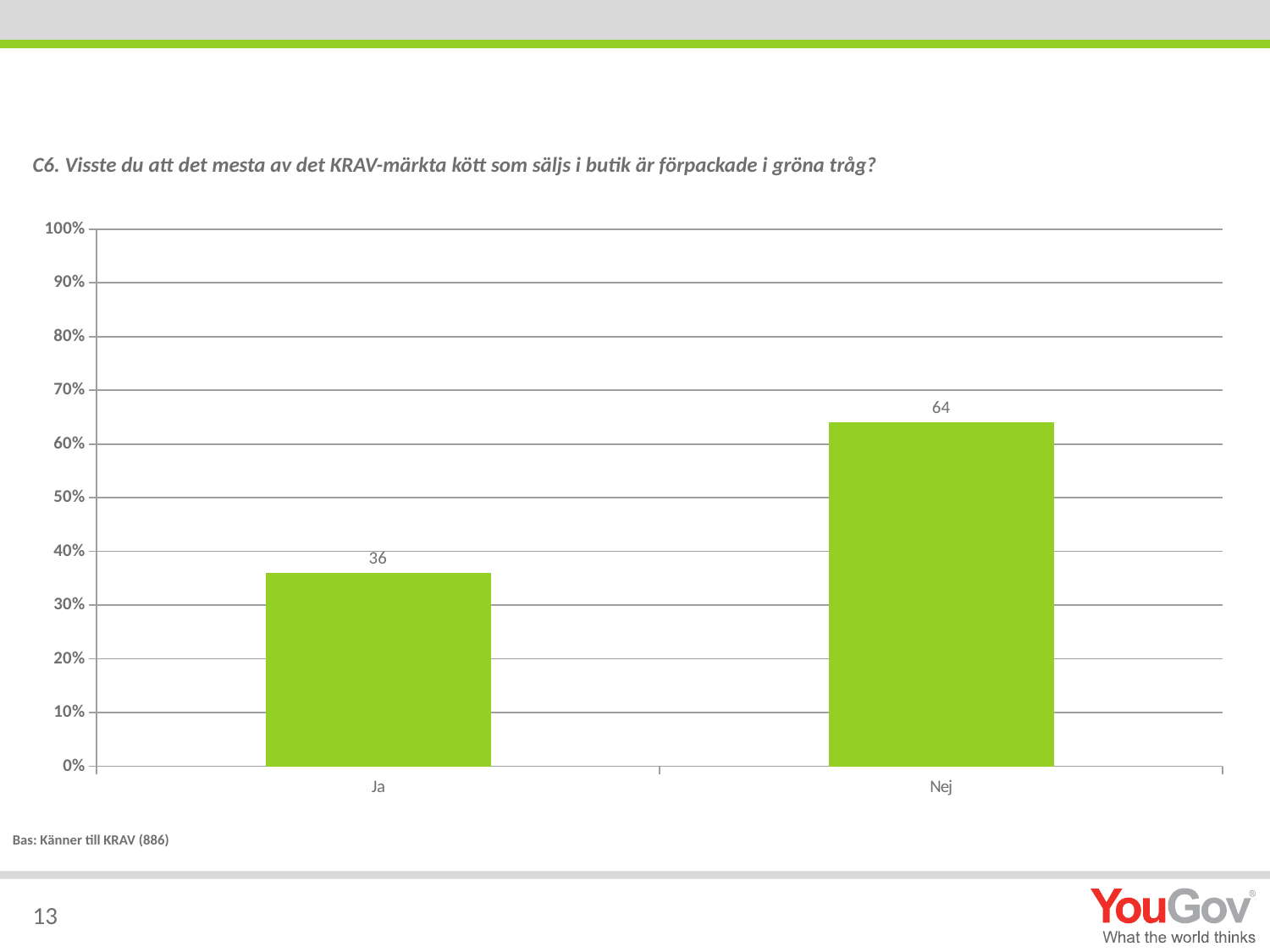
Which category has the lowest value? Ja What is the difference between the values for Nej and Ja? 28 Which is larger, the value for Ja or the value for Nej? Nej Is the value for Ja greater or less than 40%? less How many categories are shown on the x axis? 2 Is the value for Nej greater or less than 60%? greater What is the value for Ja? 36 What is the value for Nej? 64 What kind of chart is shown on the slide? bar chart What colour are the bars in the chart? green What is the highest value shown on the y axis? 100% Which category has the highest value? Nej